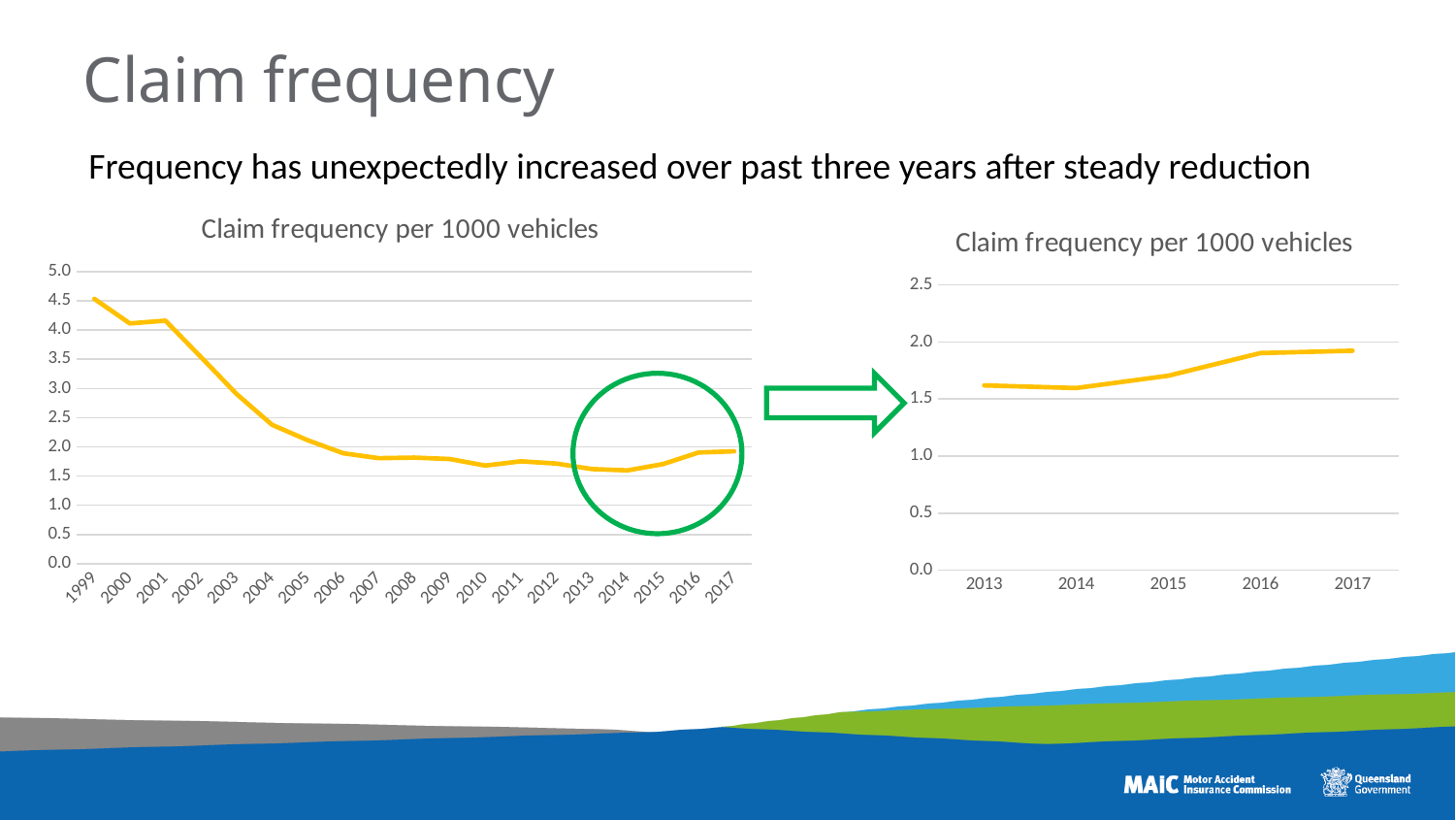
What kind of chart is the chart on the left of the slide? Line chart In the left chart, which is larger, the value for 1999 or the value for 2017? 1999 In the right chart, do the values rise or fall from 2014 to 2017? Rise What is the title of the chart on the right of the slide? Claim frequency per 1000 vehicles In the left chart, which year has the highest claim frequency? 1999 How many years are shown on the x axis of the left chart? 19 How many years are shown on the x axis of the right chart? 5 In the left chart, is the value for 1999 greater or less than 4.0? greater In the right chart, is the value for 2013 greater or less than 2.0? less What kind of chart is the chart on the right of the slide? Line chart In the right chart, is the value for 2017 greater or less than 1.5? greater